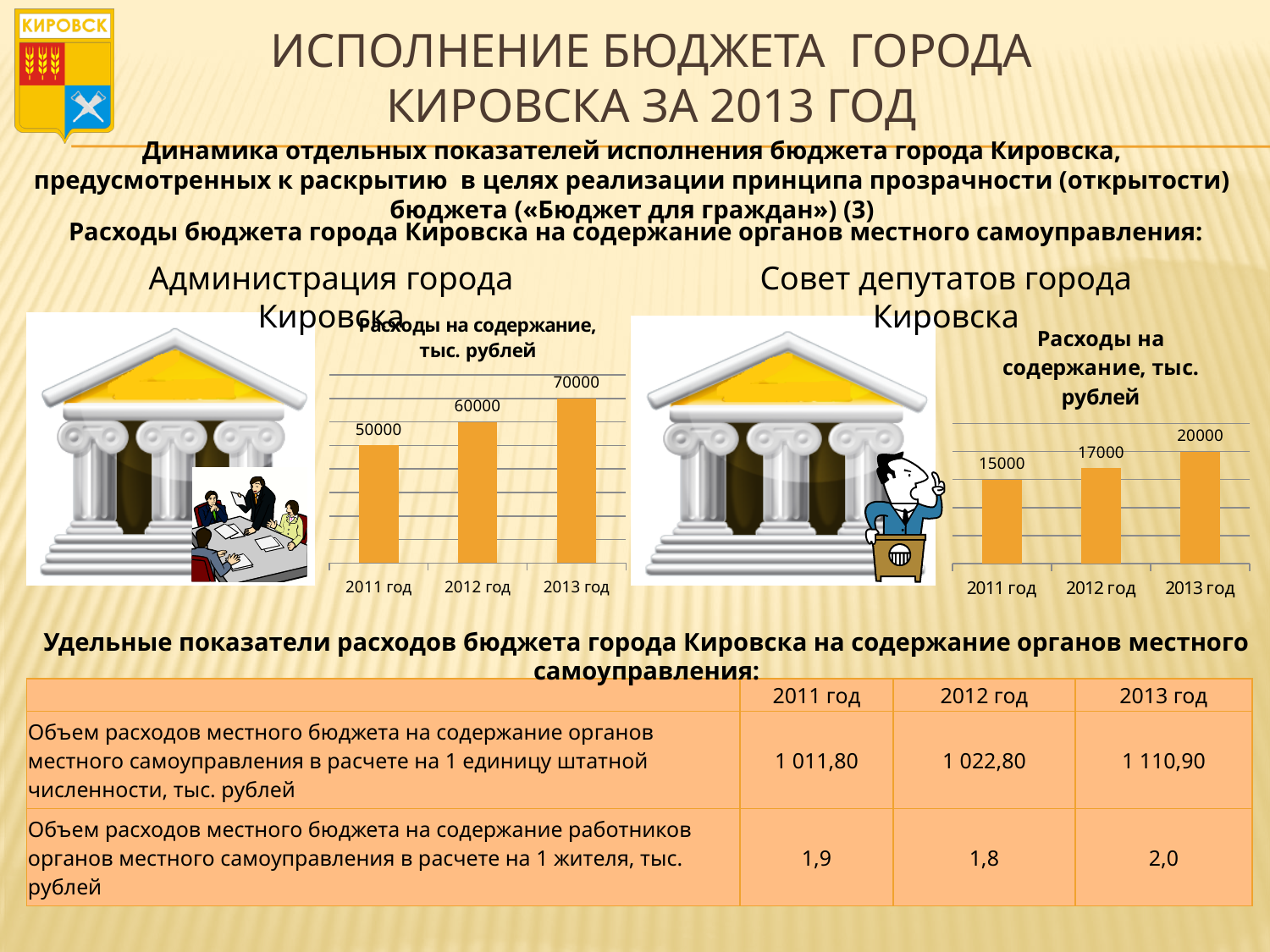
In the right chart (Совет депутатов города Кировска), which is larger: the value for 2011 год or 2012 год? 2012 год In the right chart (Совет депутатов города Кировска), which year has the lowest value? 2011 год In the left chart (Администрация города Кировска), what is the value for 2011 год? 50000 In the left chart (Администрация города Кировска), what is the difference between the values for 2013 год and 2011 год? 20000 What type of chart is the right chart (Совет депутатов города Кировска)? Bar chart In the left chart (Администрация города Кировска), which year has the highest value? 2013 год In the right chart (Совет депутатов города Кировска), what is the value for 2013 год? 20000 In the right chart (Совет депутатов города Кировска), what is the difference between the values for 2013 год and 2012 год? 3000 In the left chart (Администрация города Кировска), what is the value for 2013 год? 70000 In the left chart (Администрация города Кировска), do the values rise or fall from 2011 год to 2013 год? Rise How many bars are in the left chart (Администрация города Кировска)? 3 In the right chart (Совет депутатов города Кировска), what is the value for 2012 год? 17000